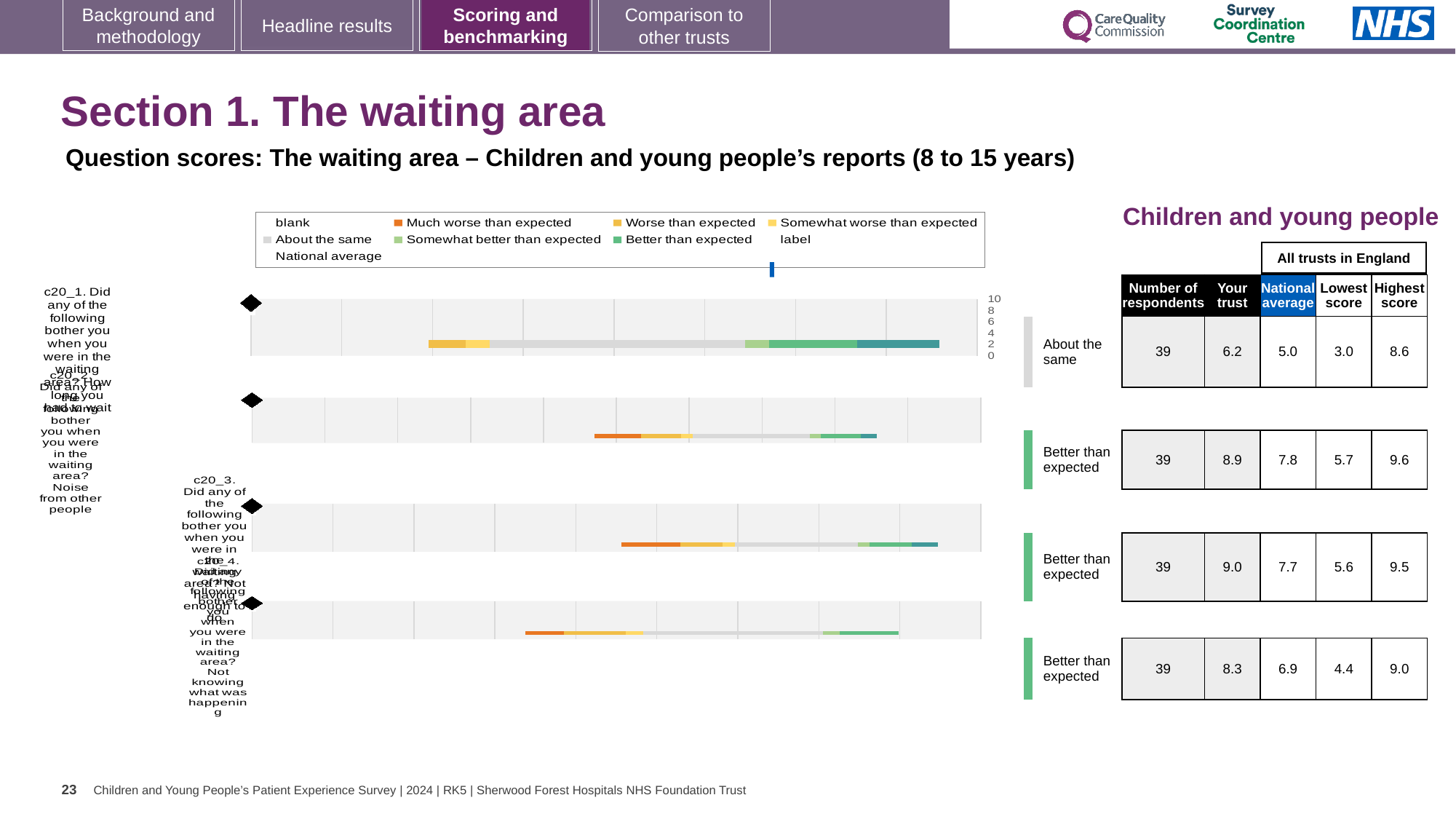
How many question bar charts are shown on the slide? 4 In the table on the right, what is the lowest score for the fourth row? 4.4 What kind of chart is used to show the question scores on the left of the slide? bar chart In the table on the right, what is the highest score for the second row? 9.6 How many respondents are listed for each question in the table? 39 In the table on the right, what is the 'Your trust' score for the first row (c20_1, About the same)? 6.2 In the table on the right, what is the national average for the first row (c20_1)? 5.0 For the first row of the table, which is larger: the 'Your trust' score or the national average? Your trust In the chart legend, what colour represents 'Much worse than expected'? orange For the first row of the table, what is the difference between the 'Your trust' score and the national average? 1.2 In the chart legend, what colour represents 'About the same'? grey Which row of the table has the lowest 'Your trust' score? the first row (c20_1), 6.2